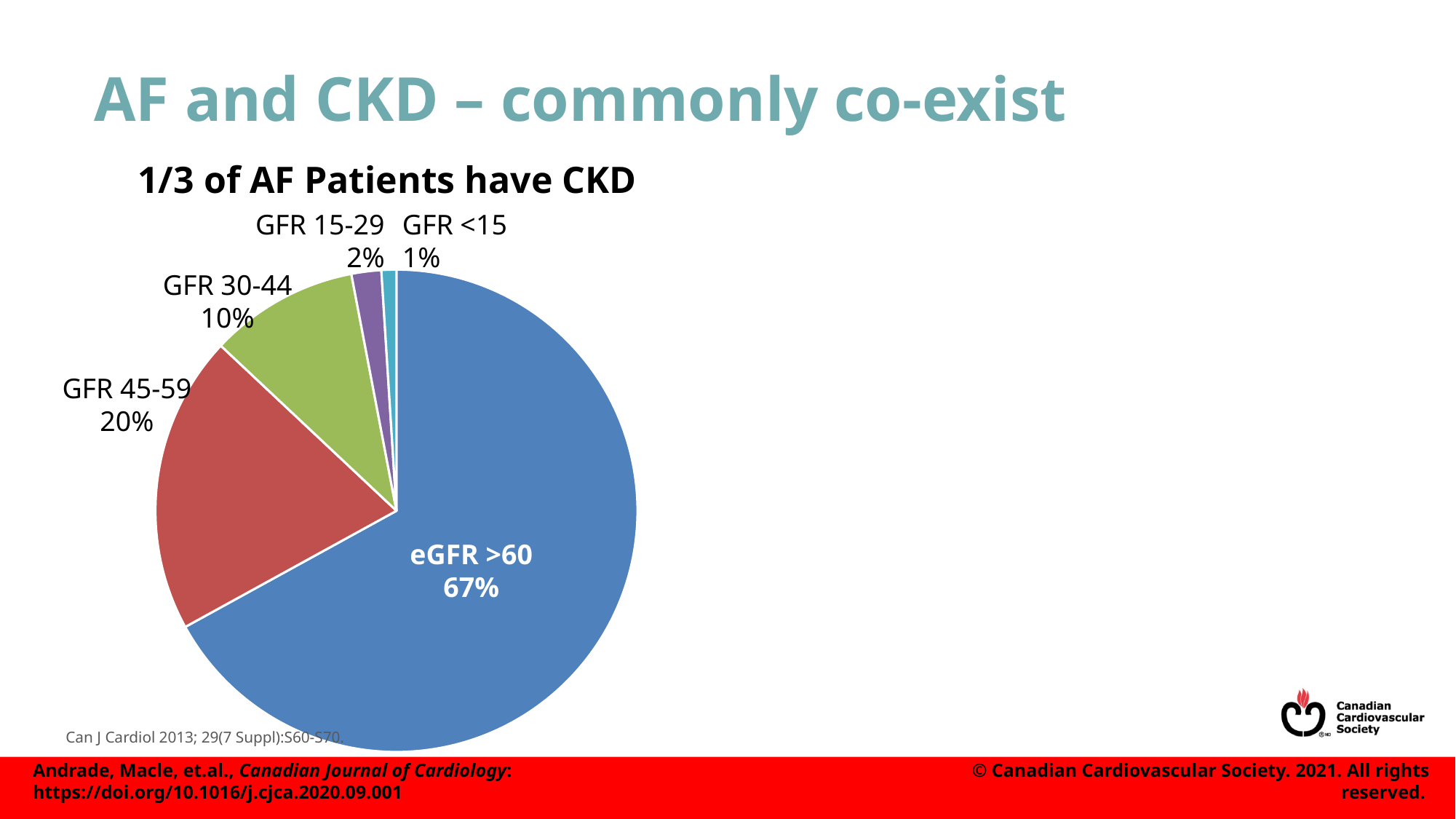
What is the value for GFR 30-44? 10% What kind of chart is shown on the slide? Pie chart Which category has the smallest slice of the pie? GFR <15 What is the value for GFR 15-29? 2% What is the title of the chart? 1/3 of AF Patients have CKD What is the value for GFR 45-59? 20% What is the difference between the GFR 45-59 and GFR 30-44 values? 10% Which category has the largest slice of the pie? eGFR >60 What share of the pie does the eGFR >60 slice represent? 67% How many slices does the pie chart have? 5 Which is larger, the GFR 30-44 slice or the GFR 15-29 slice? GFR 30-44 What is the value for GFR <15? 1%